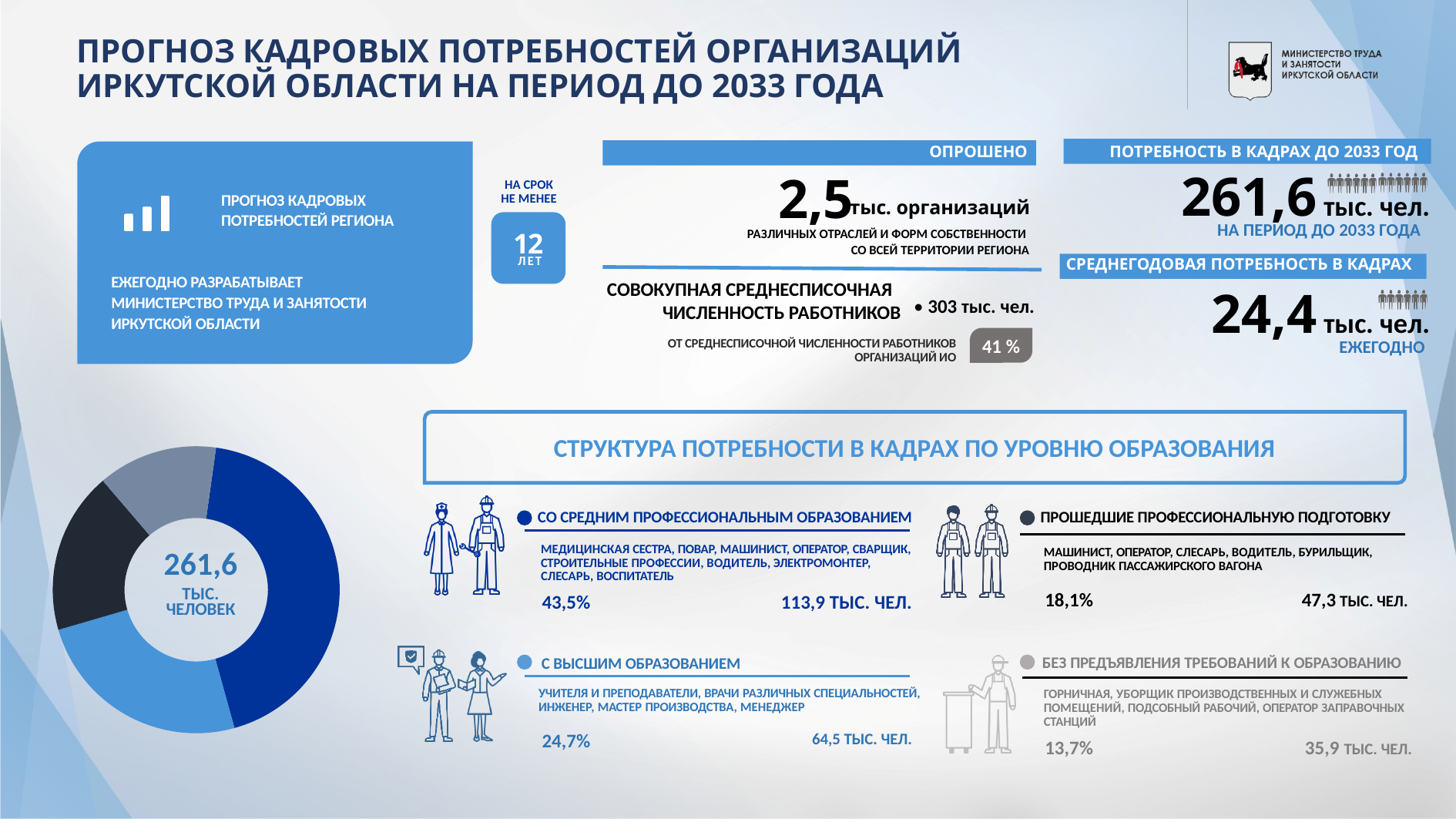
How many segments does the donut chart have? 4 What share of the staffing need is for workers who completed professional training (прошедшие профессиональную подготовку)? 18,1% What total value is printed in the centre of the donut chart? 261,6 тыс. человек How many thousand people are needed with secondary vocational education? 113,9 тыс. чел. Which education level accounts for the smallest segment of the donut chart? Без предъявления требований к образованию Which education level accounts for the largest segment of the donut chart? Со средним профессиональным образованием What share of the staffing need has no education requirements (без предъявления требований к образованию)? 13,7% What share of the staffing need is for workers with secondary vocational education (со средним профессиональным образованием)? 43,5% Which is larger: the need for workers who completed professional training or the need for workers with no education requirements? Прошедшие профессиональную подготовку What is the difference in thousand people between the need for workers with secondary vocational education (113,9) and those with higher education (64,5)? 49,4 тыс. чел. What kind of chart is shown on the left of the slide? pie chart (donut)